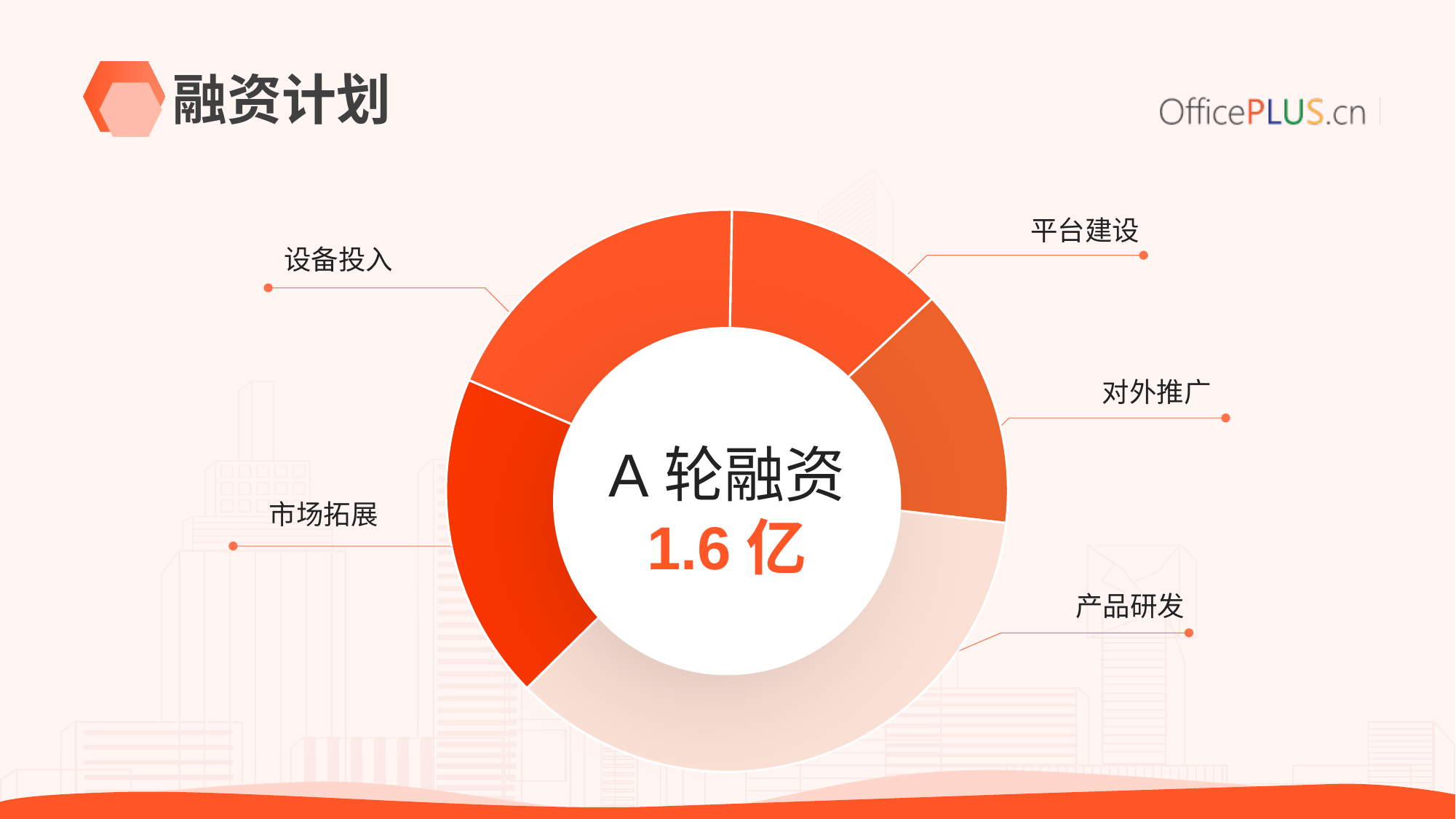
Which slice is larger, 产品研发 or 对外推广? 产品研发 What text is shown in the centre of the donut chart? A 轮融资 1.6 亿 Which category has the largest slice in the donut chart? 产品研发 Which slice is larger, 产品研发 or 平台建设? 产品研发 Which slice is larger, 市场拓展 or 产品研发? 产品研发 How many categories does the donut chart have? 5 What kind of chart is shown on the slide? Donut (pie) chart What is the title of the slide containing the donut chart? 融资计划